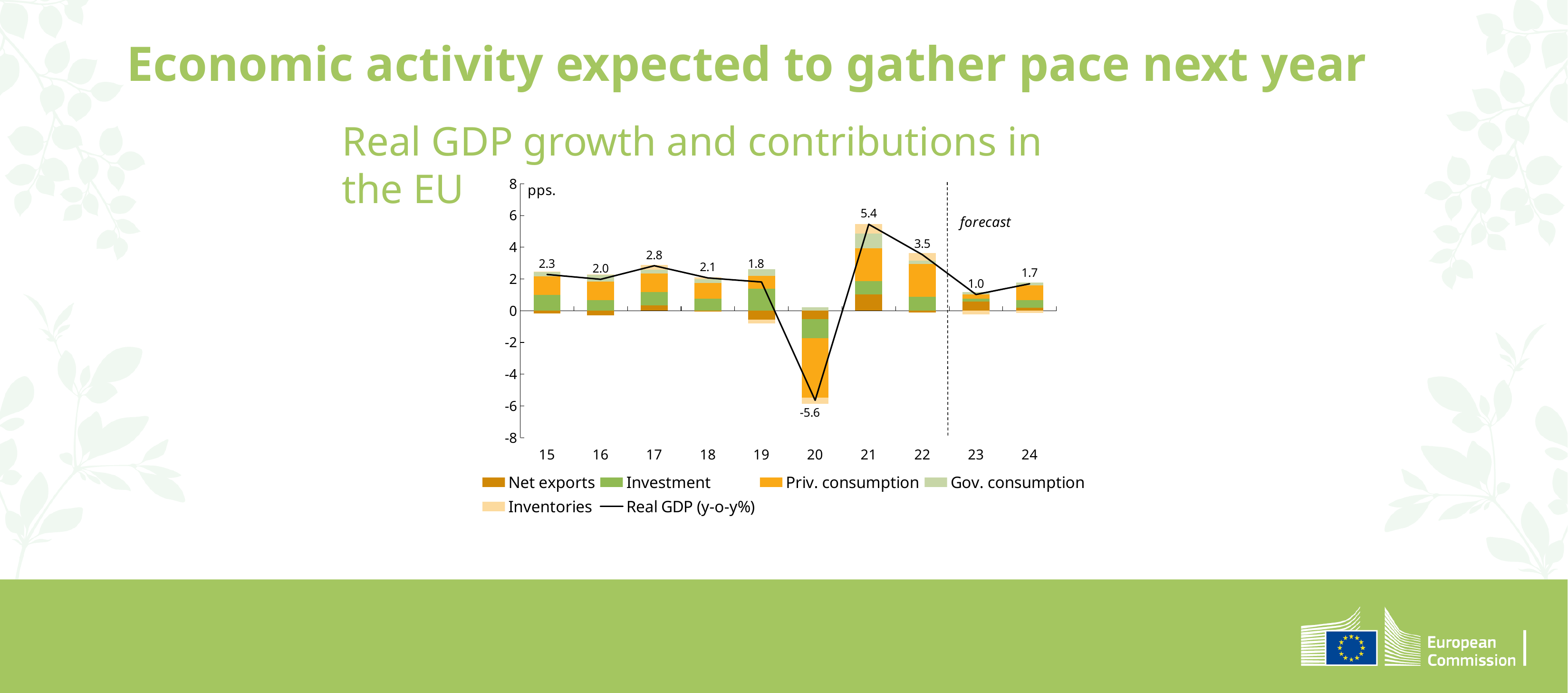
What is the difference between the Real GDP growth values for 2021 and 2022? 1.9 Which year has higher Real GDP growth, 2023 or 2024? 24 What is the Real GDP growth value shown for 2024? 1.7 How many series does the legend list? 6 What is the Real GDP growth value shown for 2020? -5.6 In which year is Real GDP growth highest? 21 What is the Real GDP growth value shown for 2021? 5.4 In which year is Real GDP growth lowest? 20 What kind of chart is this? Stacked bar chart with a line Does Real GDP growth rise or fall from 2021 to 2023? Fall How many years are shown on the x axis? 10 What is the Real GDP growth value shown for 2017? 2.8